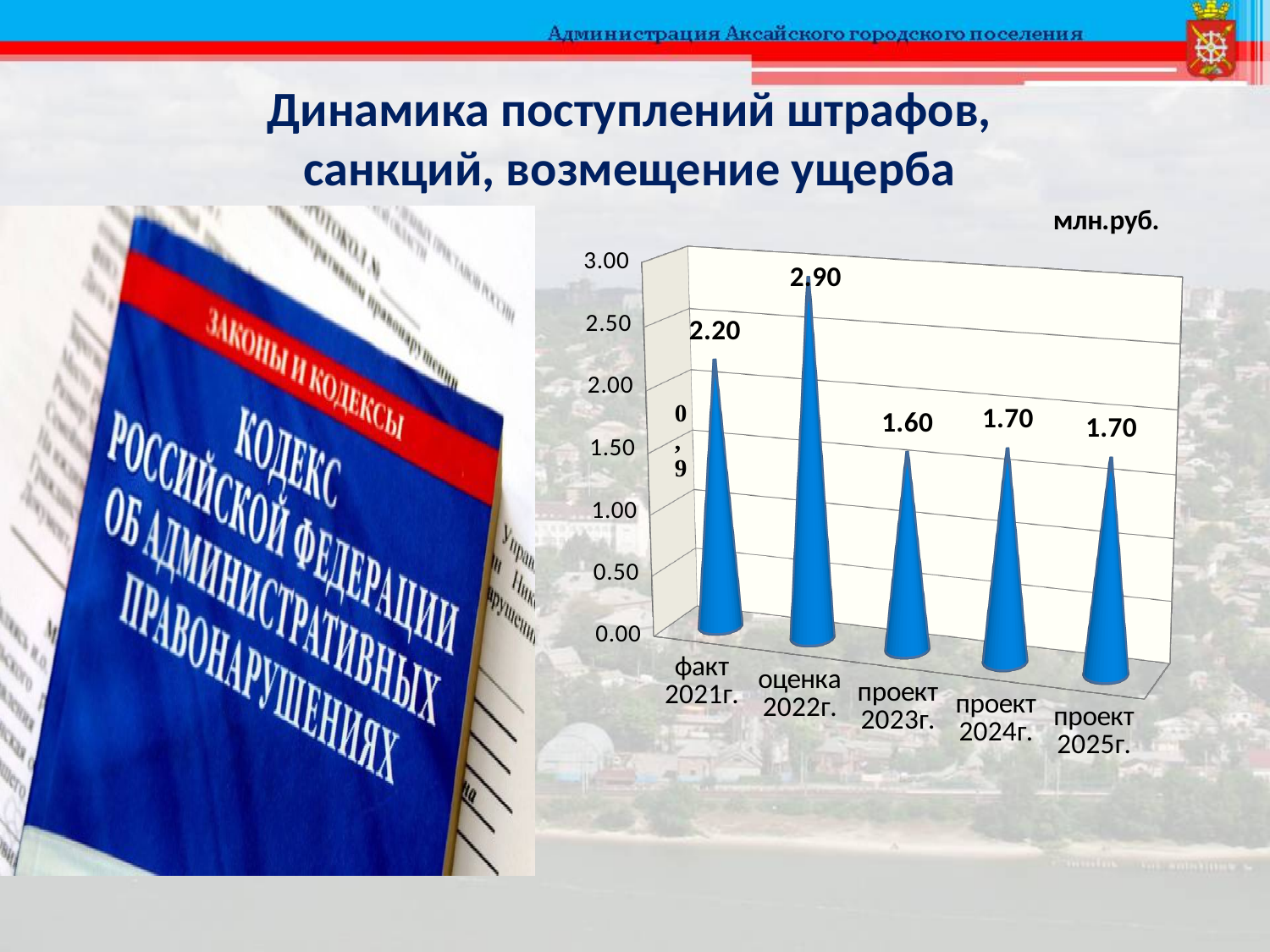
Which category has the lowest value? проект 2023г. Which is larger, the value for факт 2021г. or the value for проект 2024г.? факт 2021г. How many categories are shown on the x axis? 5 What kind of chart is shown on the slide? bar chart What is the value for проект 2025г.? 1.70 Is the value for оценка 2022г. greater or less than 2.50? greater What unit of measurement is indicated above the chart? млн.руб. What is the value for оценка 2022г.? 2.90 What is the value for факт 2021г.? 2.20 Which category has the highest value? оценка 2022г. What is the value for проект 2023г.? 1.60 What is the difference between the values for оценка 2022г. and факт 2021г.? 0.70